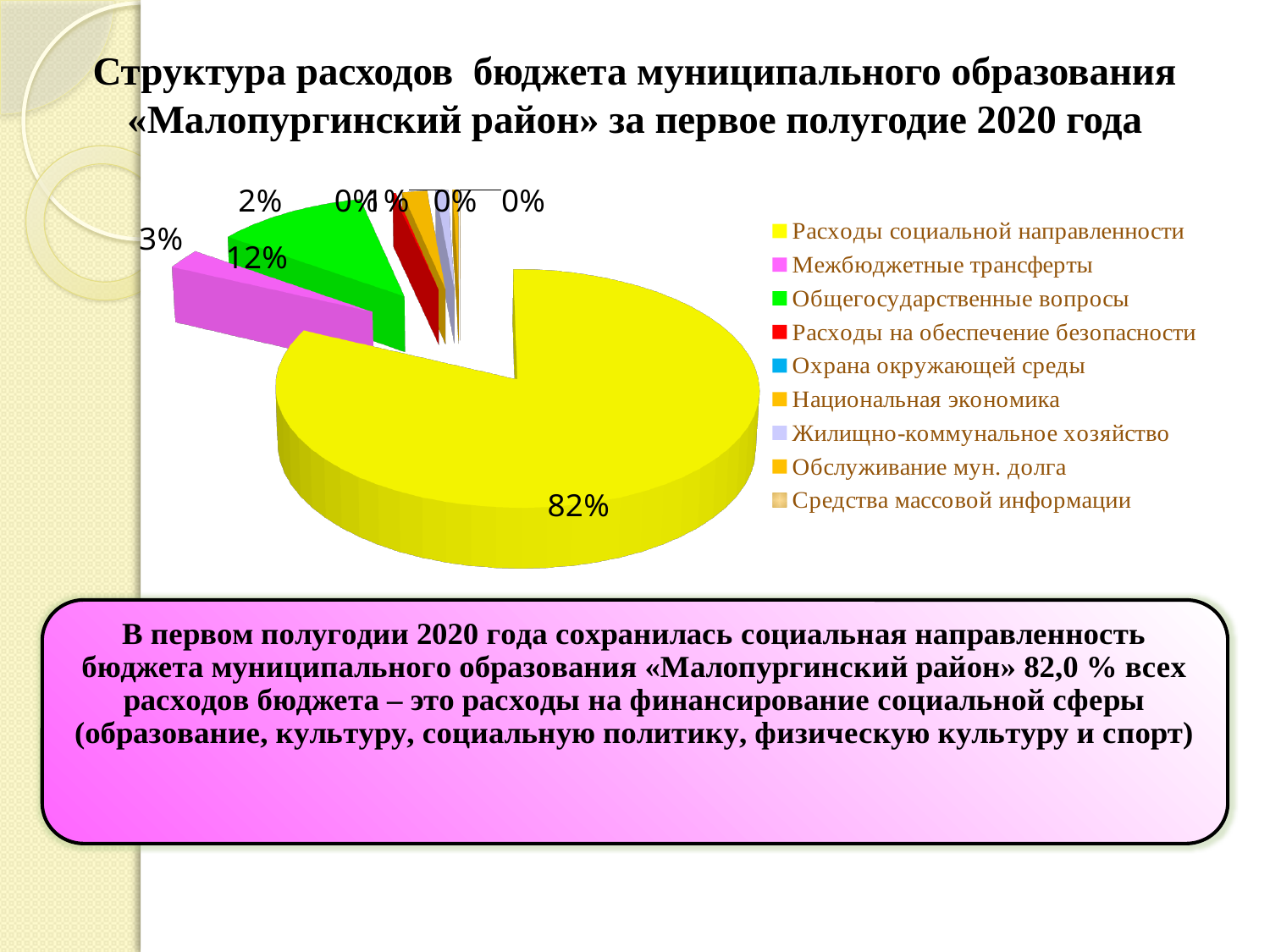
Which is larger: the slice for «Межбюджетные трансферты» or the slice for «Общегосударственные вопросы»? Общегосударственные вопросы Which colour represents «Расходы социальной направленности» in the legend? yellow What is the difference in percentage points between the «Расходы социальной направленности» slice and the «Межбюджетные трансферты» slice? 79 Which category has the largest slice of the pie? Расходы социальной направленности Is the share for «Расходы социальной направленности» greater or less than 50%? greater What share of the pie does «Расходы социальной направленности» take? 82% How many categories does the legend list? 9 What type of chart is shown on the slide? pie chart Which colour represents «Межбюджетные трансферты» in the legend? pink What share of the pie does «Межбюджетные трансферты» take? 3%